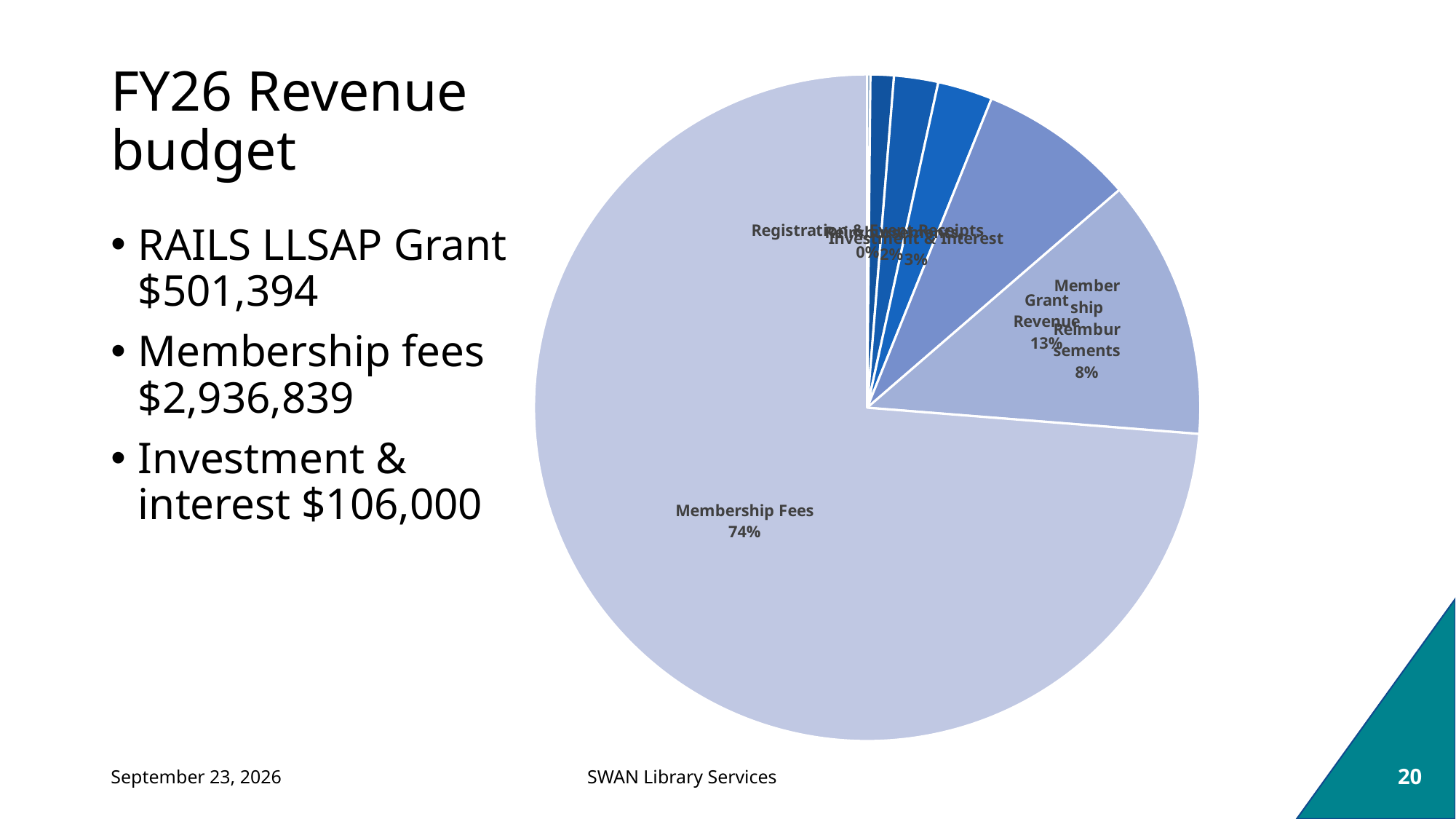
What is the difference in percentage points between Grant Revenue and Membership Reimbursements? 5 percentage points What is the title of the slide containing the pie chart? FY26 Revenue budget What kind of chart is shown on the slide? pie chart Does the pie chart use a separate legend or labels placed on the slices? labels on the slices What percentage is shown for Investment & Interest? 3% What share of the pie is Membership Fees? 74% What percentage is shown for Membership Reimbursements? 8% What is the difference in percentage points between Membership Fees and Grant Revenue? 61 percentage points Which is larger, Grant Revenue or Membership Reimbursements? Grant Revenue What percentage is shown for Grant Revenue? 13% Is the Membership Fees share greater or less than 50%? greater Which category has the largest slice of the pie? Membership Fees